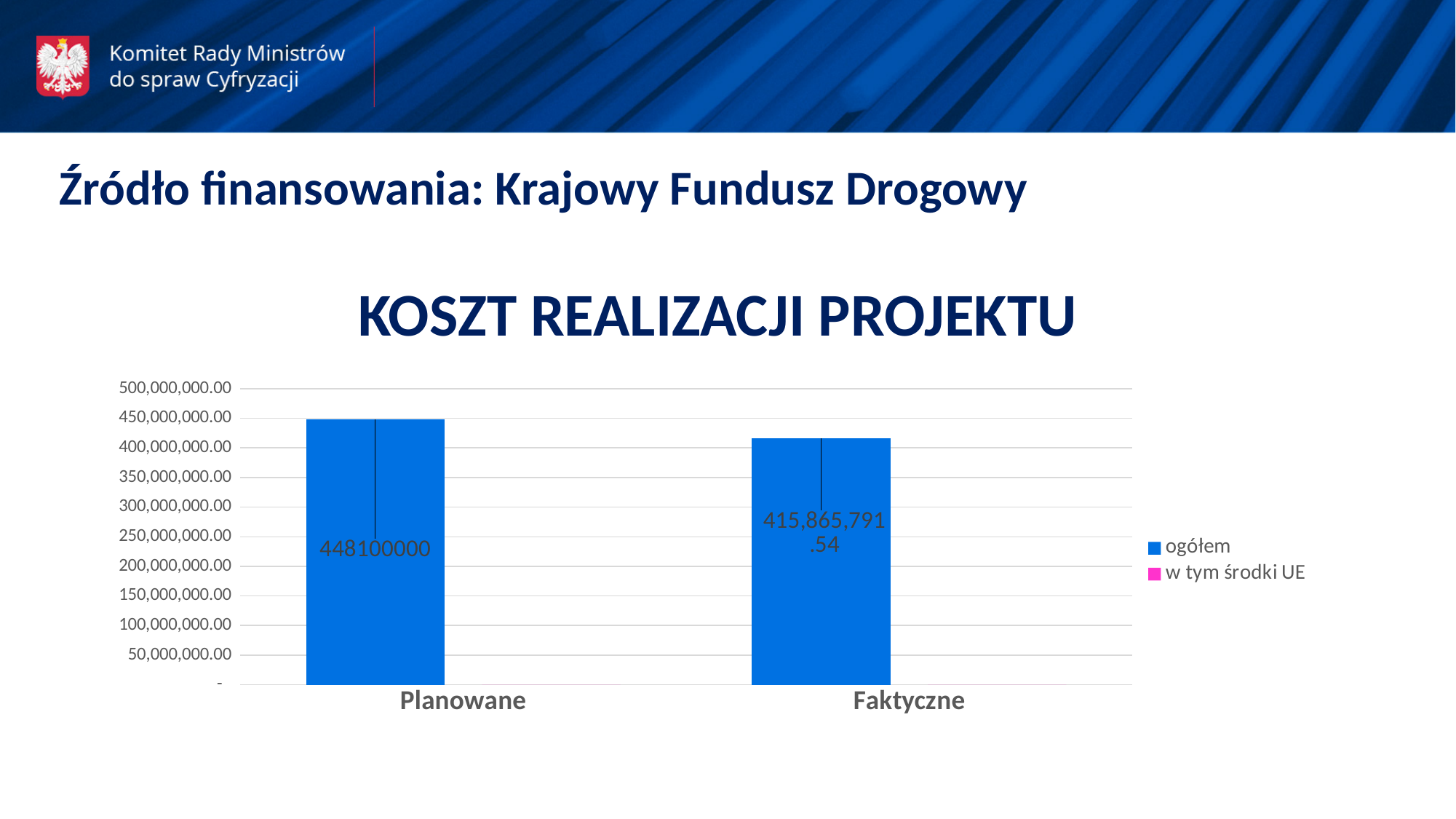
What is the 'ogółem' value for Planowane? 448100000 What is the title of the chart? KOSZT REALIZACJI PROJEKTU How many series does the chart legend list? 2 Is the 'ogółem' value for Faktyczne greater or less than 450,000,000.00? less Which category has the lowest 'ogółem' value? Faktyczne What is the difference between the 'ogółem' values for Planowane and Faktyczne? 32,234,208.46 Does the 'ogółem' value fall or rise from Planowane to Faktyczne? fall What are the two series named in the chart legend? ogółem, w tym środki UE Which category has the higher 'ogółem' value, Planowane or Faktyczne? Planowane What is the 'ogółem' value for Faktyczne? 415,865,791.54 What type of chart is shown on the slide? bar chart How many categories are shown on the x axis of the chart? 2